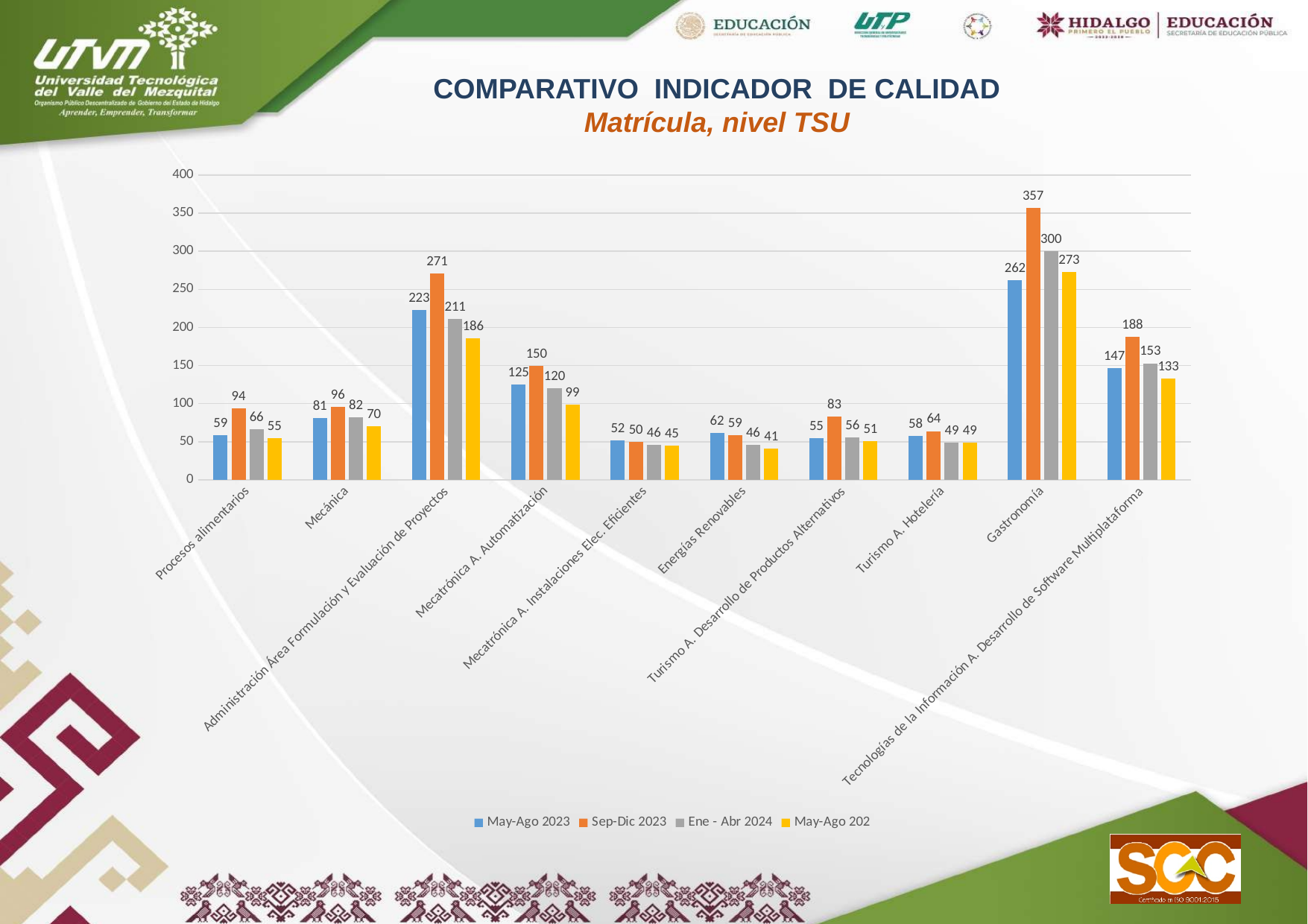
What is the value for Energías Renovables in the May-Ago 2023 series? 62 Which is larger for Turismo A. Desarrollo de Productos Alternativos: the Sep-Dic 2023 value or the Ene - Abr 2024 value? Sep-Dic 2023 What is the value for Mecánica in the Ene - Abr 2024 series? 82 How many series does the legend list? 4 What type of chart is shown on the slide? Bar chart Is the Ene - Abr 2024 value for Gastronomía greater or less than 250? greater What is the subtitle of the chart shown below the main title? Matrícula, nivel TSU How many categories are shown on the x axis? 10 Which category has the lowest value in the Ene - Abr 2024 series? Mecatrónica A. Instalaciones Elec. Eficientes and Energías Renovables (tied at 46) What is the difference between the Sep-Dic 2023 and May-Ago 2023 values for Administración Área Formulación y Evaluación de Proyectos? 48 Which category has the highest value in the Sep-Dic 2023 series? Gastronomía What is the value for Gastronomía in the Sep-Dic 2023 series? 357